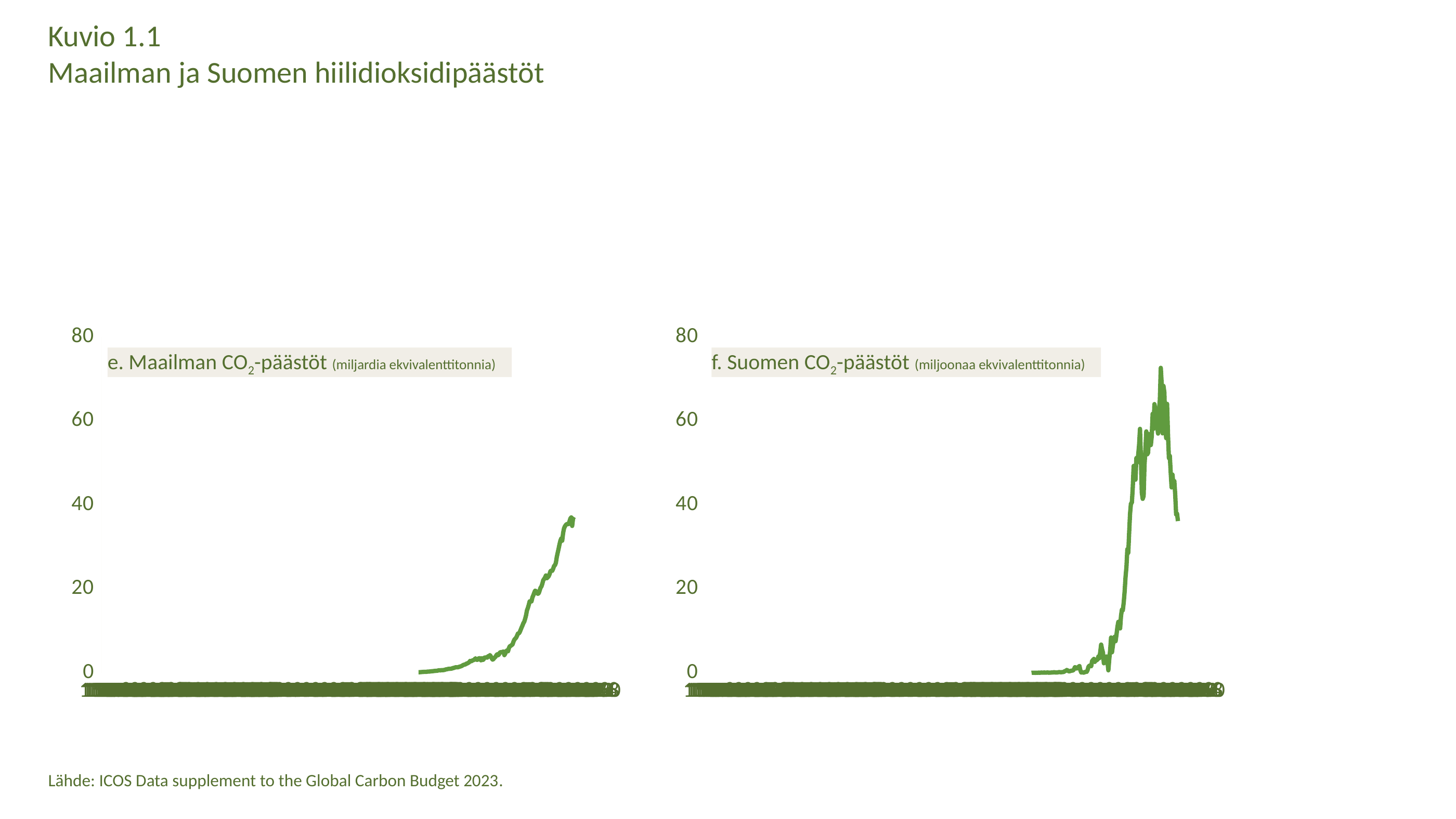
What unit is given in the title of the right chart, "f. Suomen CO2-päästöt"? miljoonaa ekvivalenttitonnia In the left chart, "e. Maailman CO2-päästöt", is the highest point of the line greater or less than 40? less What kind of chart is the right chart, "f. Suomen CO2-päästöt"? line chart What is the highest value shown on the y axis of the left chart, "e. Maailman CO2-päästöt"? 80 How many charts are shown on the slide? 2 In the right chart, "f. Suomen CO2-päästöt", is the last point of the line greater or less than 40? less In the right chart, "f. Suomen CO2-päästöt", is the last point of the line greater or less than 20? greater In the left chart, "e. Maailman CO2-päästöt", do the values generally rise or fall along the x axis? rise What kind of chart is the left chart, "e. Maailman CO2-päästöt"? line chart